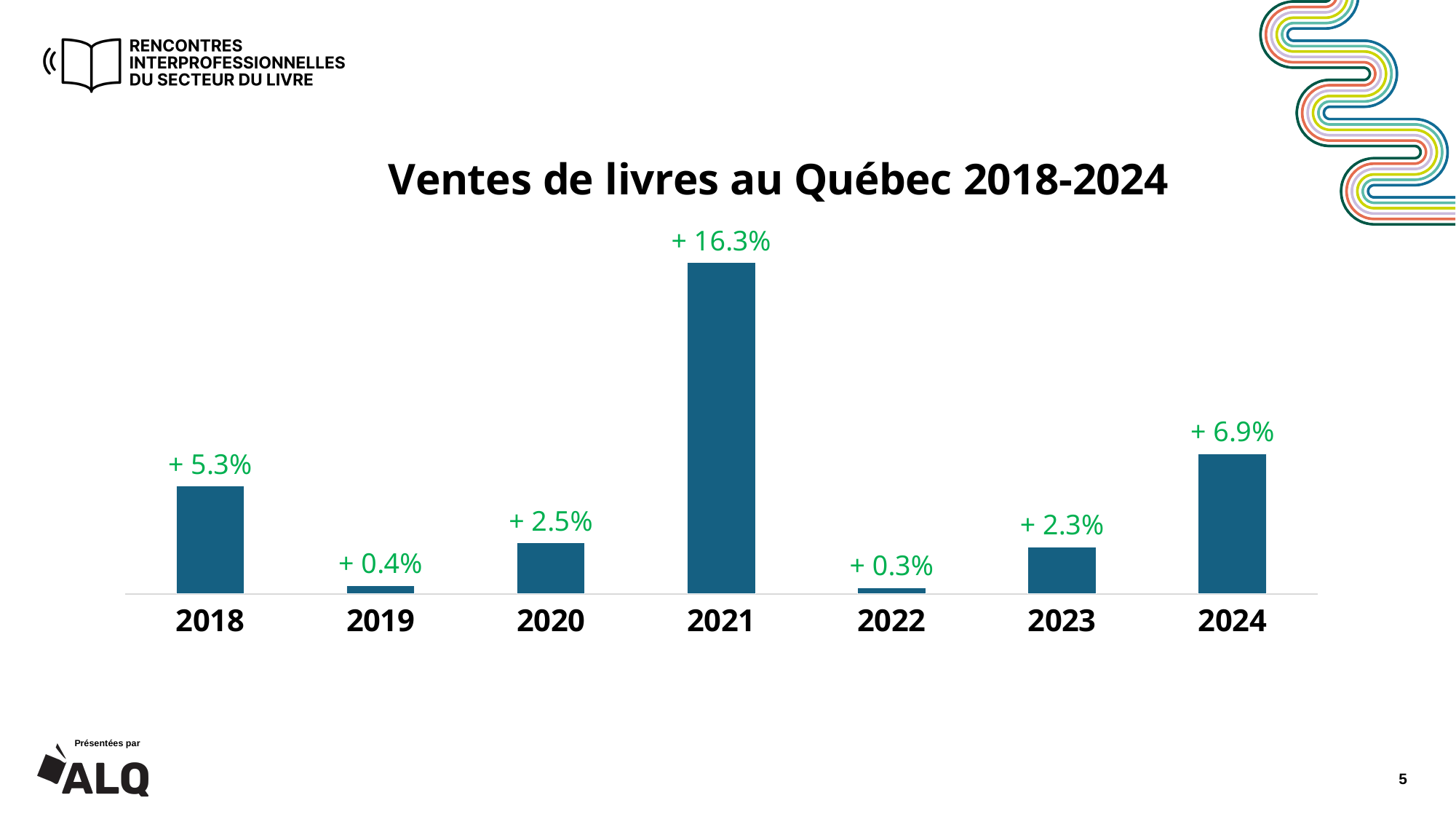
How many years are shown on the x axis? 7 Which is larger, the value for 2018 or the value for 2024? 2024 What is the value shown for 2021? + 16.3% What kind of chart is this? Bar chart What is the difference between the values for 2021 and 2024? 9.4% Which year has the lowest value? 2022 What is the value shown for 2022? + 0.3% What is the value shown for 2018? + 5.3% Which year has the highest value? 2021 What is the value shown for 2024? + 6.9% What is the title of the chart? Ventes de livres au Québec 2018-2024 What is the difference between the values for 2020 and 2023? 0.2%